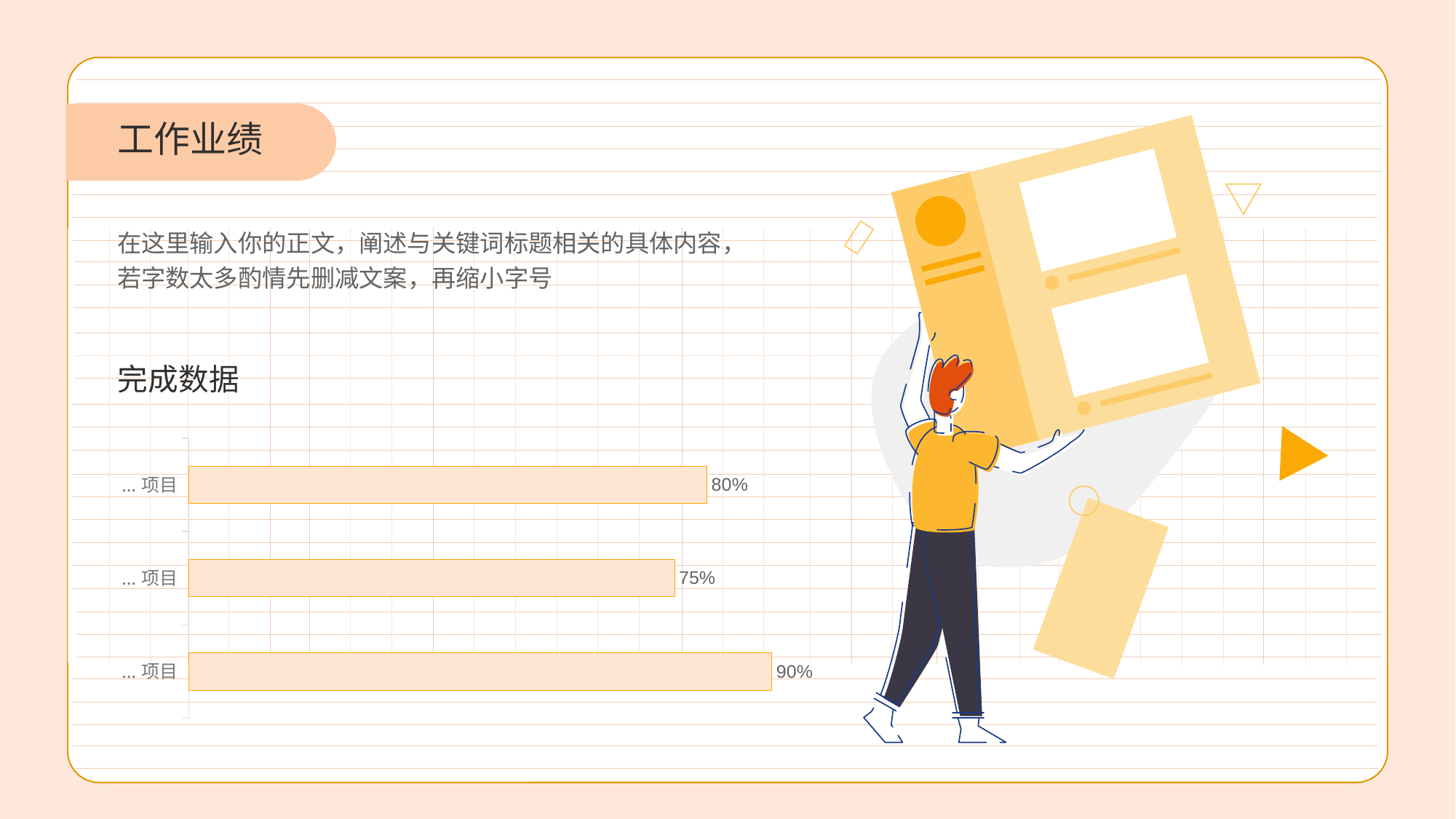
What is the value shown for the top bar in the chart? 80% What is the value shown for the middle bar in the chart? 75% Which bar has the lowest value: the top, middle or bottom bar? middle Which is larger, the value of the top bar or the value of the middle bar? top bar What is the difference between the top bar's value and the middle bar's value? 5% What is the heading printed above the bar chart? 完成数据 How many bars does the chart under 完成数据 contain? 3 What is the value shown for the bottom bar in the chart? 90% What label is printed next to each bar in the chart? ... 项目 What kind of chart is shown under the heading 完成数据? bar chart Which bar has the highest value: the top, middle or bottom bar? bottom What is the difference between the bottom bar's value and the top bar's value? 10%